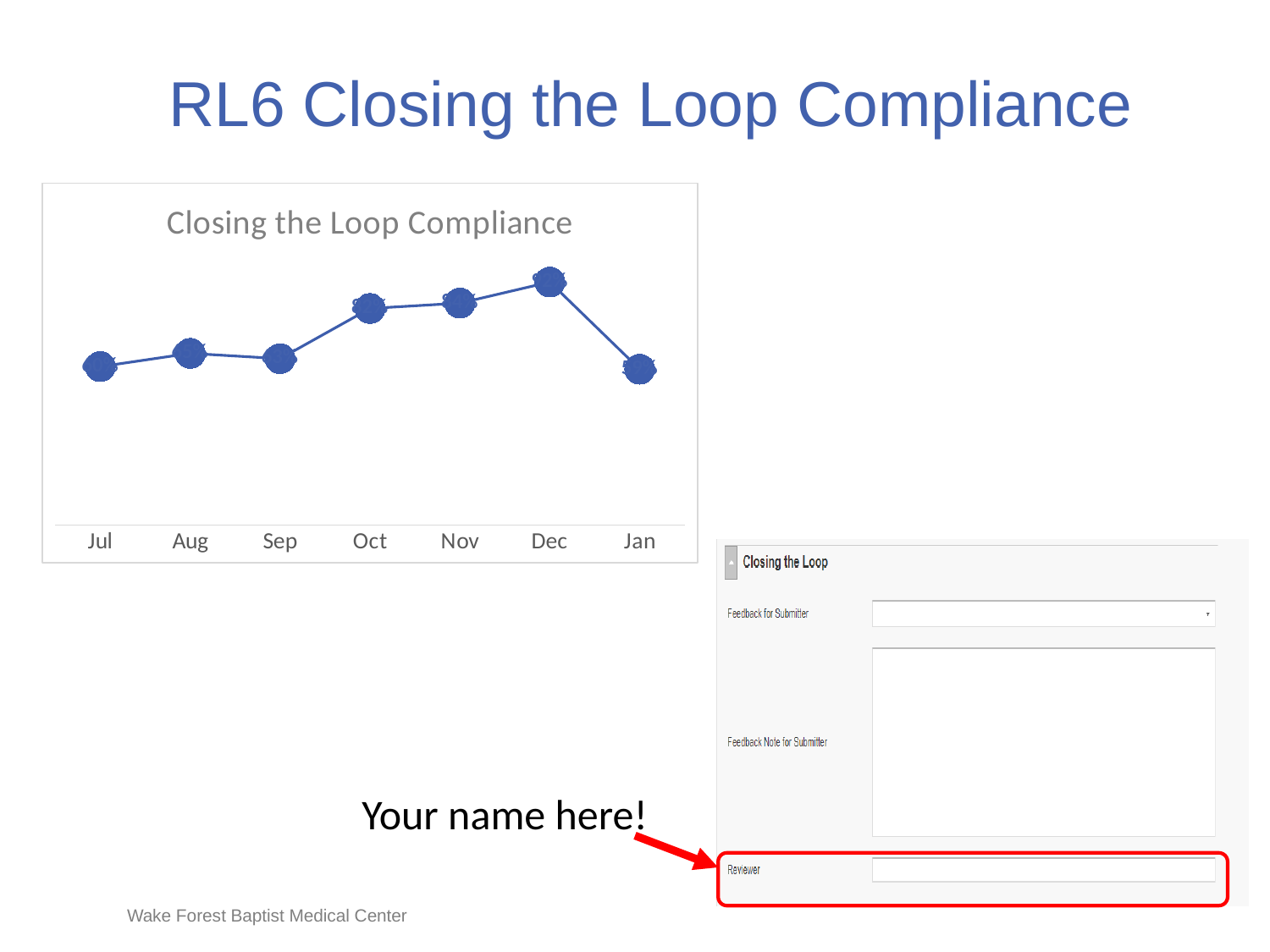
How many months are plotted on the x axis of the chart? 7 What kind of chart is shown on the slide? line chart Which is higher in the chart, the value for Dec or the value for Jan? Dec Does the value rise or fall from Sep to Oct in the chart? rise Does the value rise or fall from Dec to Jan in the chart? fall What is the first month shown on the x axis of the chart? Jul Which is higher in the chart, the value for Oct or the value for Aug? Oct What is the title of the chart? Closing the Loop Compliance Which is higher in the chart, the value for Nov or the value for Sep? Nov Which month has the highest value in the chart? Dec